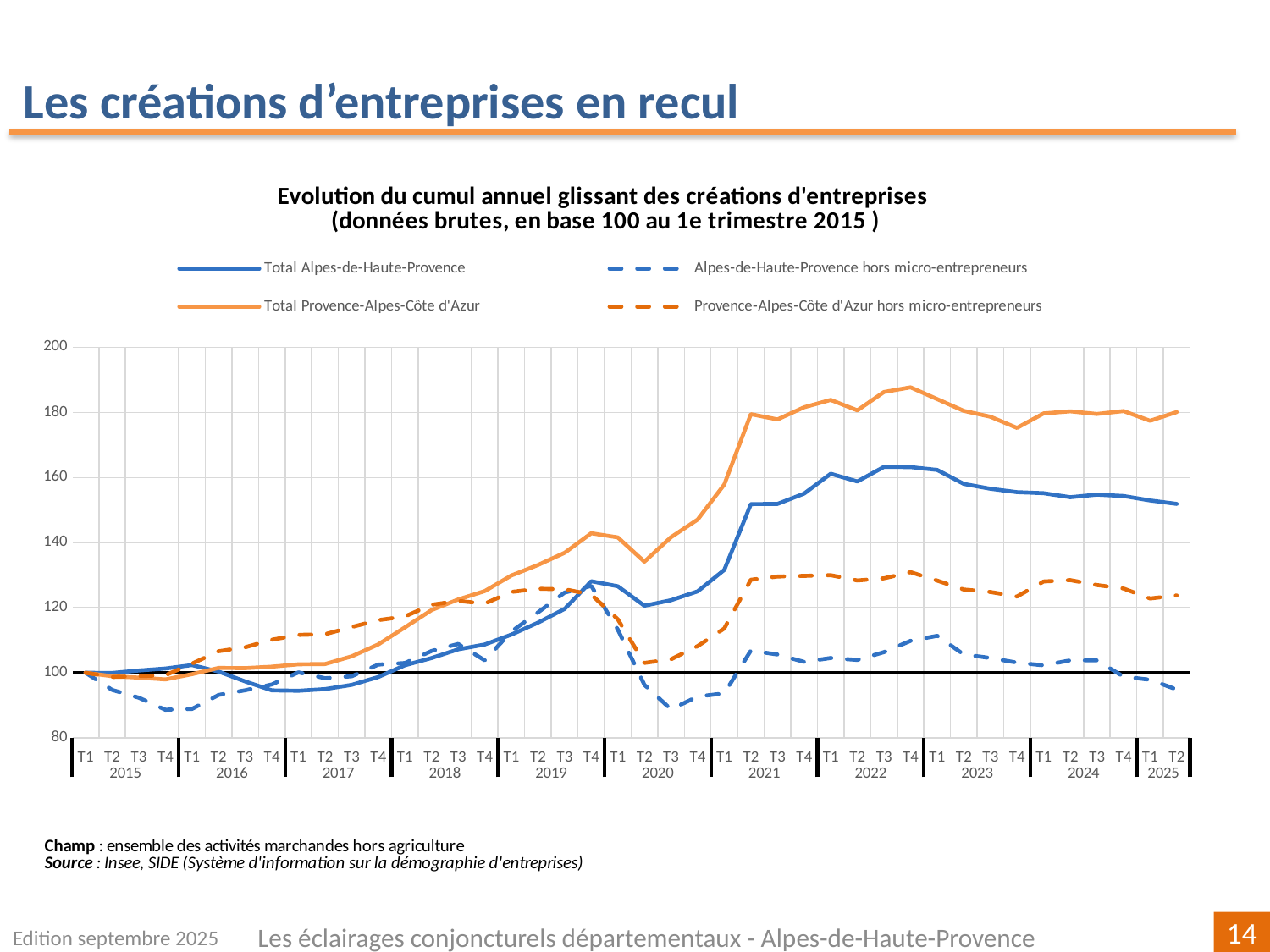
Which series reaches the highest value on the chart? Total Provence-Alpes-Côte d'Azur Is the value for Alpes-de-Haute-Provence hors micro-entrepreneurs at T2 2025 greater or less than 100? less What is the title of the chart? Evolution du cumul annuel glissant des créations d'entreprises (données brutes, en base 100 au 1e trimestre 2015 ) At T2 2025, which is higher: Total Provence-Alpes-Côte d'Azur or Total Alpes-de-Haute-Provence? Total Provence-Alpes-Côte d'Azur How many series does the legend list? 4 Is the value for Provence-Alpes-Côte d'Azur hors micro-entrepreneurs at T2 2025 greater or less than 120? greater What kind of chart is shown on the slide? line chart Is the value for Alpes-de-Haute-Provence hors micro-entrepreneurs at T2 2020 greater or less than 100? less How many years are labelled on the x axis? 11 Between T4 2022 and T2 2025, does the Total Alpes-de-Haute-Provence series rise or fall? fall